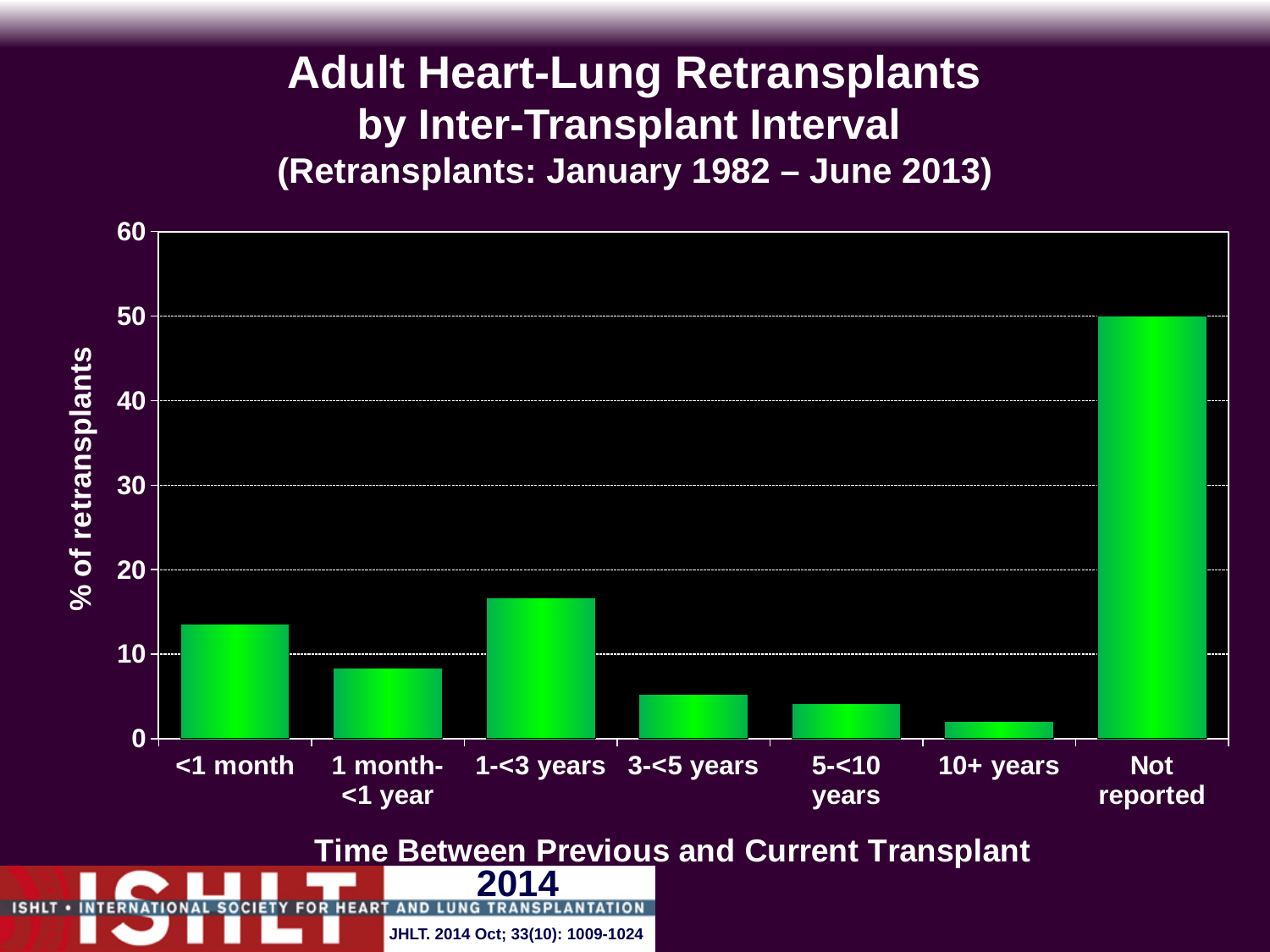
How many inter-transplant interval categories are shown on the x axis? 7 Which category has the highest percentage of retransplants? Not reported Which category has the lowest percentage of retransplants? 10+ years Which is larger, the value for <1 month or the value for 1 month-<1 year? <1 month Is the value for <1 month greater or less than 10? greater What is the label of the y axis? % of retransplants Which is larger, the value for 3-<5 years or the value for 10+ years? 3-<5 years Among the categories with a reported interval, which has the highest percentage of retransplants? 1-<3 years What is the label of the x axis? Time Between Previous and Current Transplant Is the value for 1-<3 years greater or less than 20? less Is the value for Not reported greater or less than 40? greater What kind of chart is shown on the slide? bar chart